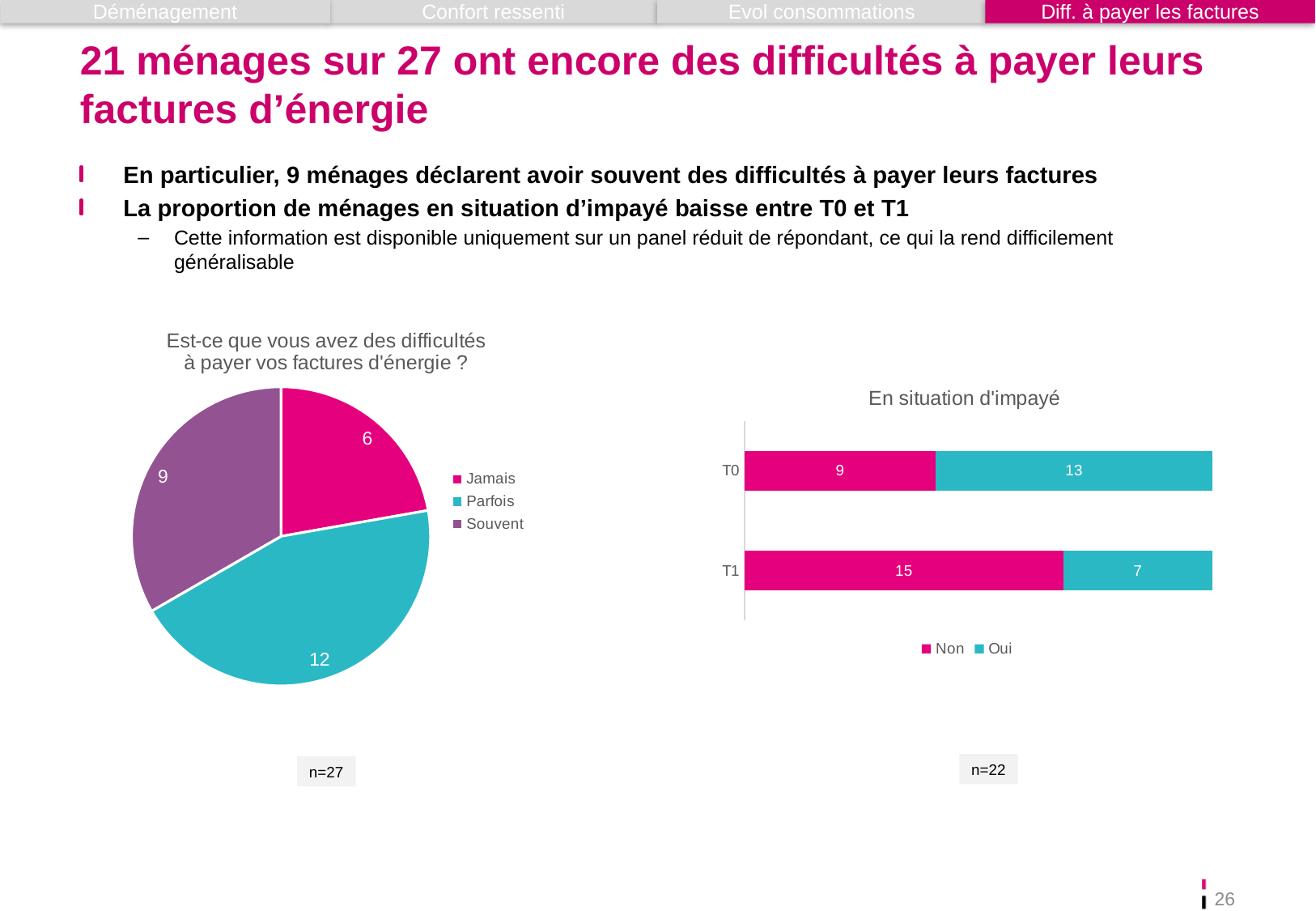
In the chart 'En situation d'impayé', what is the total of the T1 bar? 22 In the chart 'En situation d'impayé', how many series does the legend list? 2 In the pie chart 'Est-ce que vous avez des difficultés à payer vos factures d'énergie ?', what is the difference between Souvent and Jamais? 3 In the pie chart 'Est-ce que vous avez des difficultés à payer vos factures d'énergie ?', how many categories does the legend list? 3 In the pie chart 'Est-ce que vous avez des difficultés à payer vos factures d'énergie ?', which category has the largest slice? Parfois In the chart 'En situation d'impayé', what is the value for Oui at T0? 13 In the chart 'En situation d'impayé', what is the value for Non at T1? 15 In the chart 'En situation d'impayé', which is larger at T0, Non or Oui? Oui In the pie chart 'Est-ce que vous avez des difficultés à payer vos factures d'énergie ?', what is the value for Parfois? 12 In the pie chart 'Est-ce que vous avez des difficultés à payer vos factures d'énergie ?', which category has the smallest slice? Jamais What kind of chart is 'En situation d'impayé'? Stacked bar chart In the chart 'En situation d'impayé', what is the difference between Oui at T0 and Oui at T1? 6